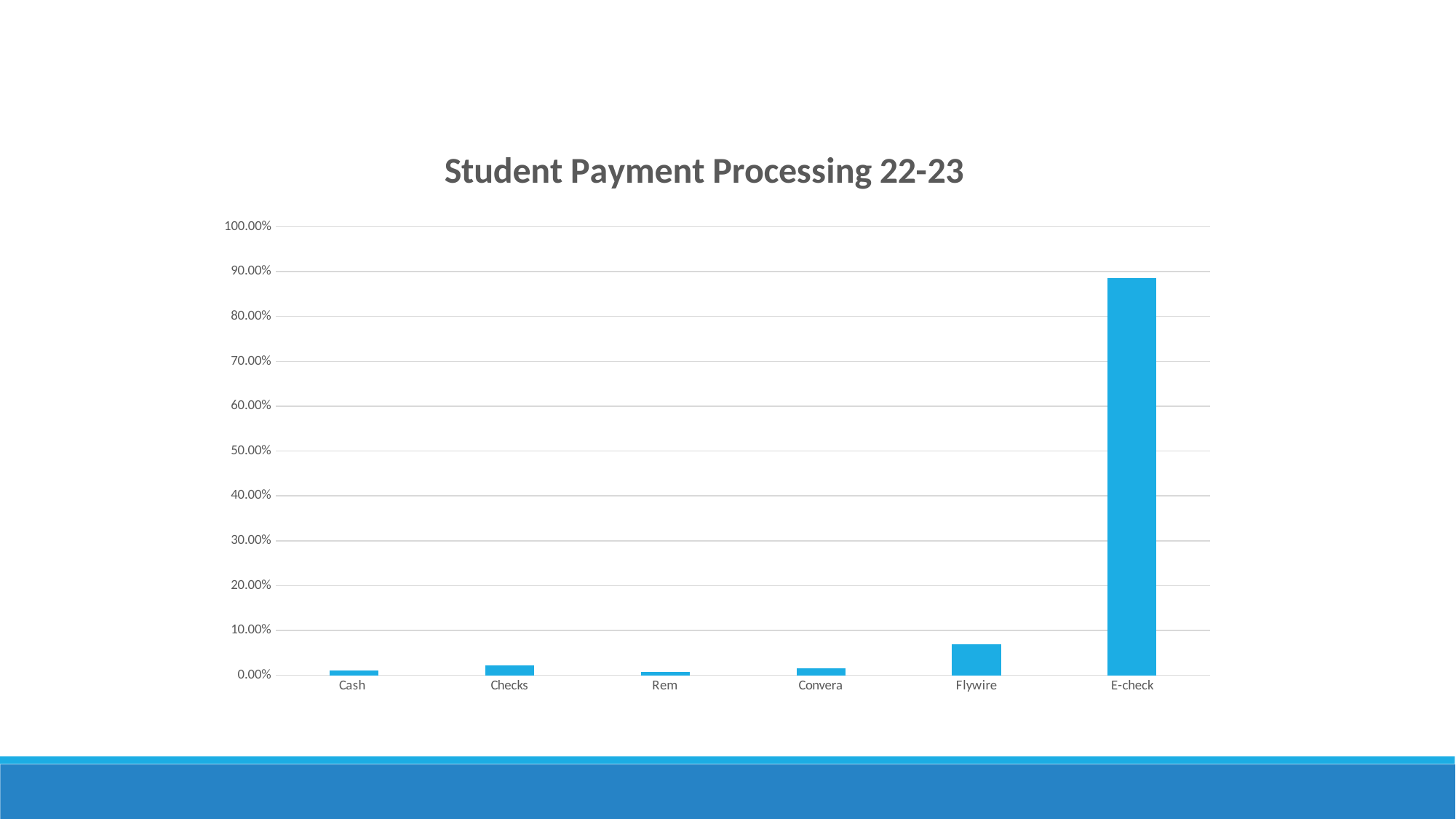
What is the highest value shown on the y axis? 100.00% What is the title of the chart? Student Payment Processing 22-23 Is the value for Checks greater or less than 10.00%? less Which is larger, the value for Flywire or the value for Convera? Flywire Which is larger, the value for Flywire or the value for Cash? Flywire Is the value for E-check greater or less than 80.00%? greater Is the value for E-check greater or less than 50.00%? greater Which category has the highest value? E-check How many payment categories are shown on the x axis? 6 What type of chart is shown on the slide? bar chart Which is larger, the value for E-check or the value for Flywire? E-check